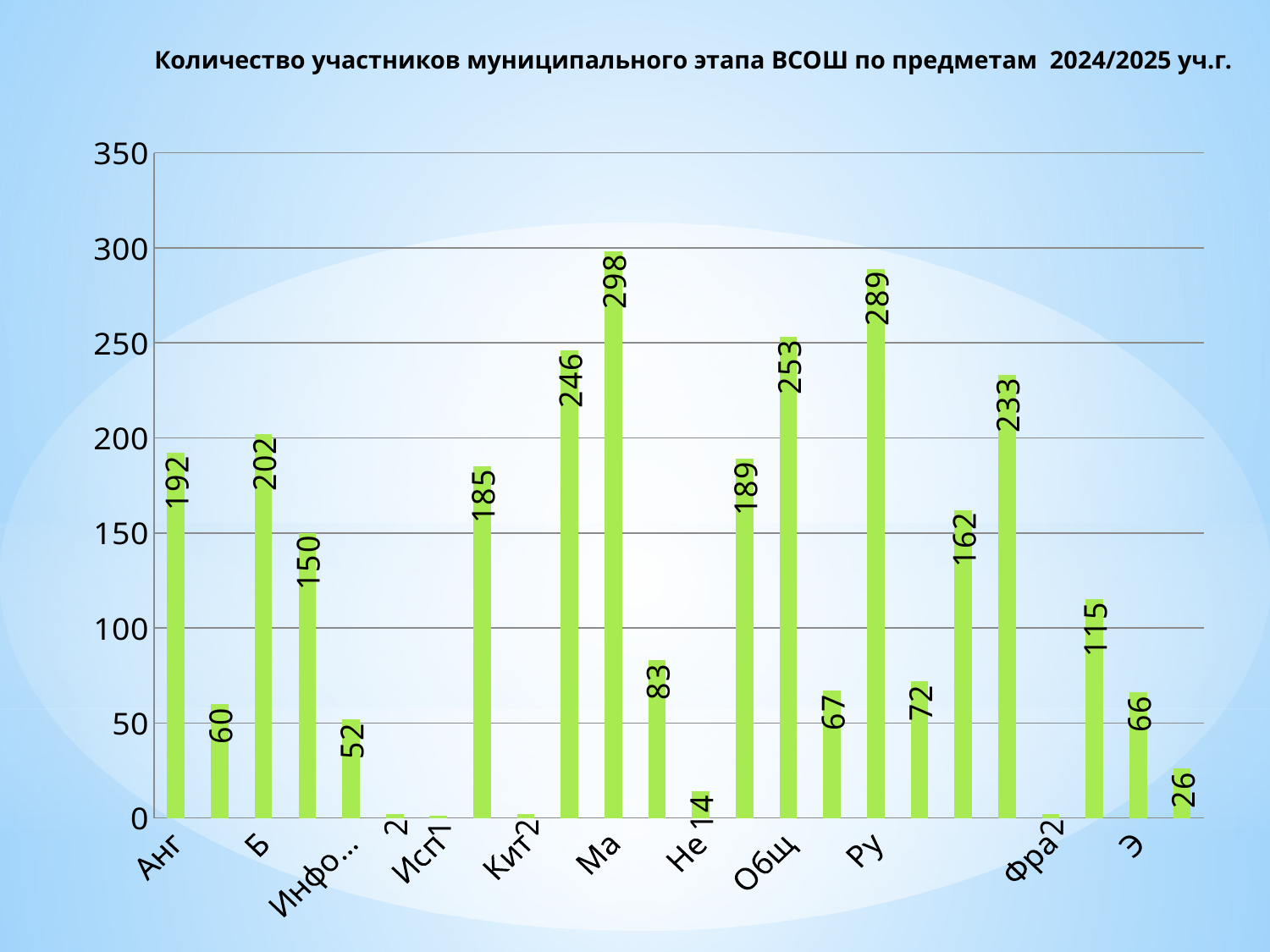
Which is larger, the value for Общ or the value for Б? Общ What is the value for Общ? 253 Which category has the highest value? Ма What is the difference between the values for Ма and Ру? 9 What is the value for Ма? 298 What is the value for Б? 202 How many bars are plotted in the chart? 24 What type of chart is shown on the slide? bar chart What is the value for Э? 66 What is the title of the chart? Количество участников муниципального этапа ВСОШ по предметам 2024/2025 уч.г. What is the value for Ру? 289 What is the value for Анг? 192